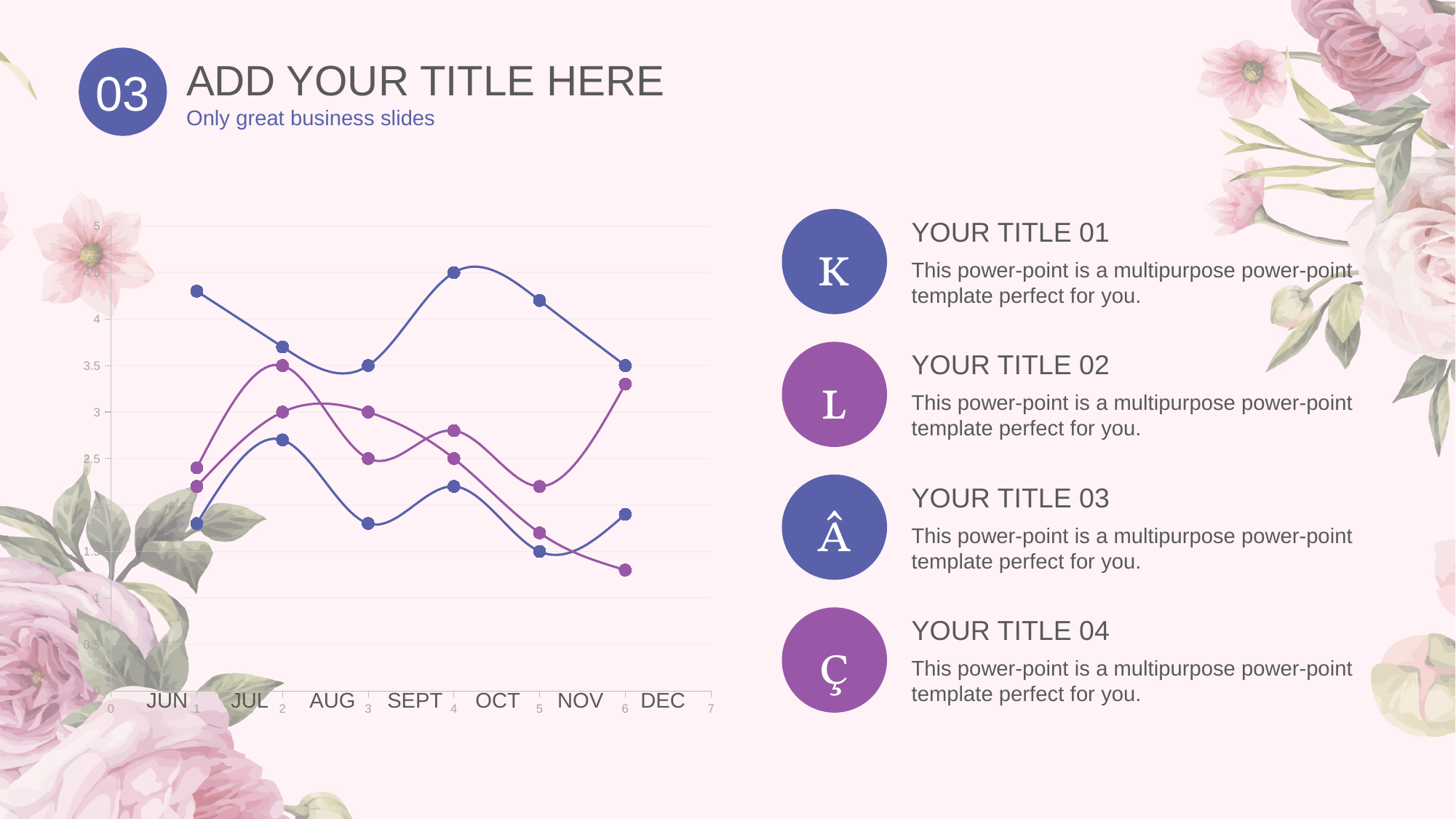
What is the highest value shown on the chart's y axis? 5 Is the highest plotted point on the chart greater or less than 4? greater How many month labels appear along the x axis of the chart? 7 How many lines are plotted on the chart? 4 Which month label appears first on the x axis of the chart? JUN Does the chart include a legend identifying the lines? No What kind of chart is shown on the slide? line chart Is the lowest plotted point on the chart greater or less than 1.5? less